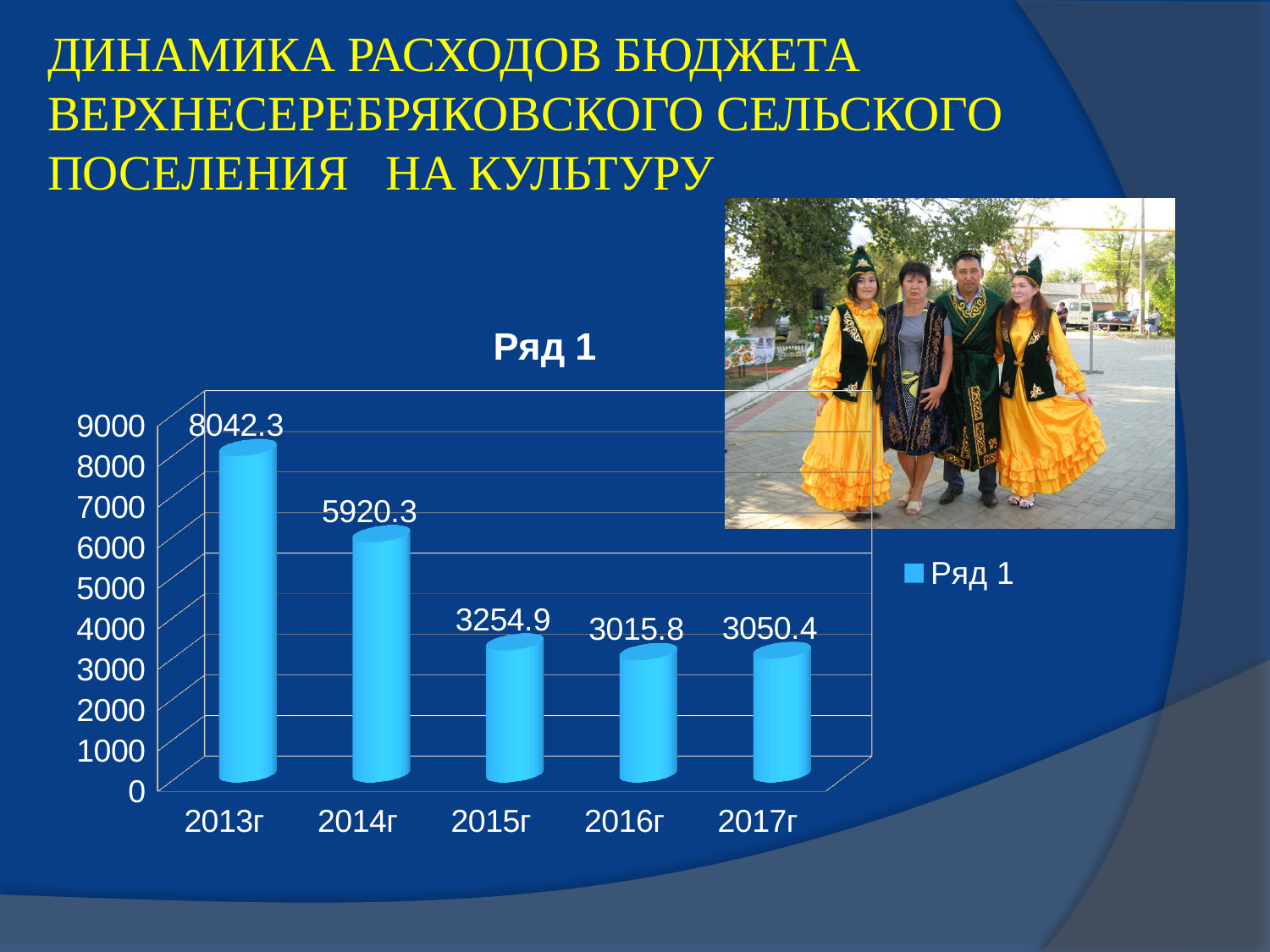
Is the value for 2014г greater or less than 5000? greater Which is larger, the value for 2014г or the value for 2015г? 2014г What is the difference between the values for 2015г and 2016г? 239.1 Which year has the lowest value? 2016г What kind of chart is shown on the slide? bar chart What is the name of the series shown in the legend? Ряд 1 What is the value for 2013г? 8042.3 What is the difference between the values for 2013г and 2014г? 2122 How many years are shown on the x axis? 5 Which year has the highest value? 2013г What is the value for 2017г? 3050.4 What is the value for 2015г? 3254.9